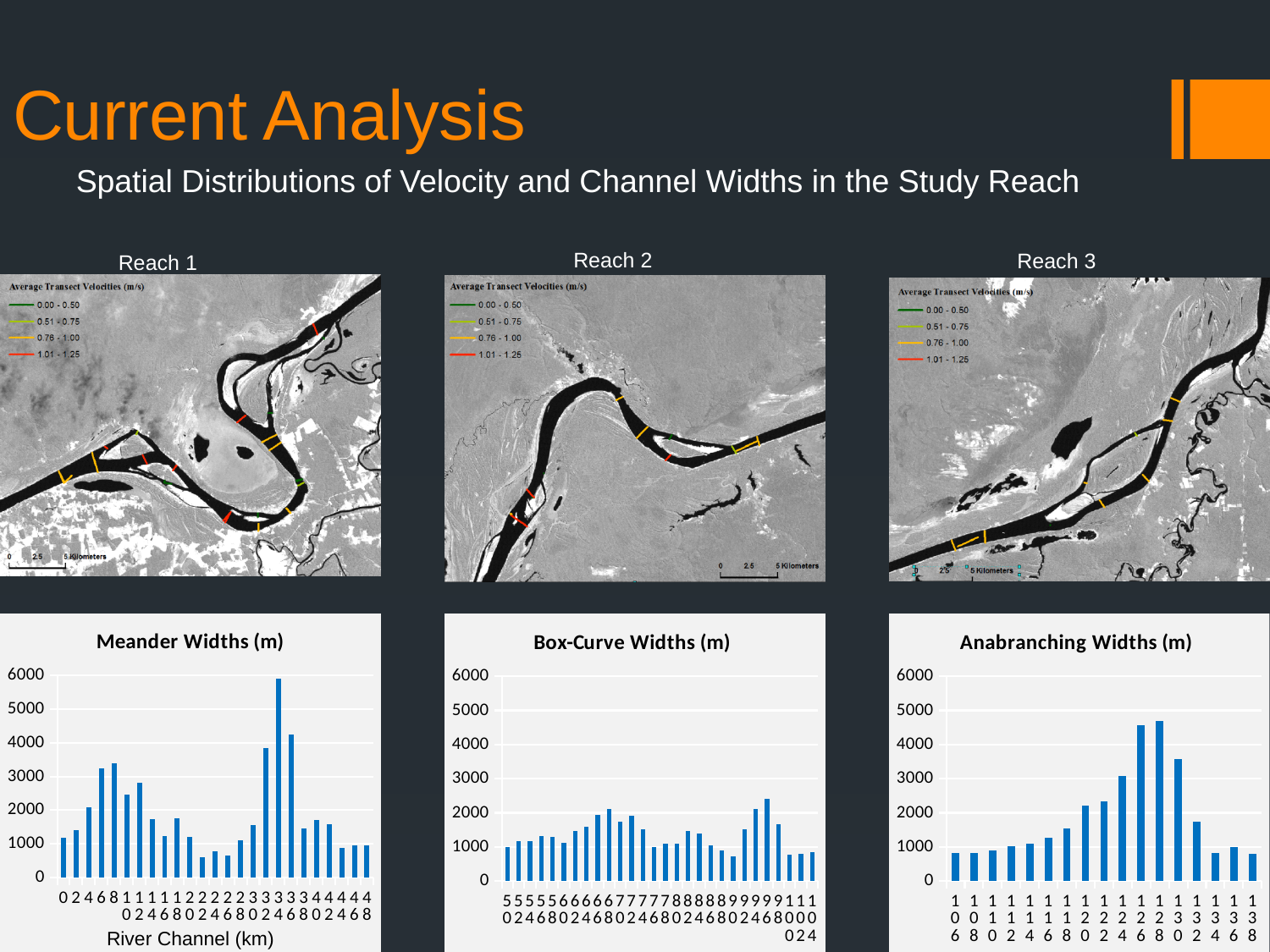
How many bars are plotted in the Anabranching Widths (m) chart? 17 Which of the three width charts contains the tallest bar overall? Meander Widths (m) What is the title of the chart below the Reach 3 map? Anabranching Widths (m) In the Meander Widths (m) chart, is the shortest bar greater or less than 1000? less How many bars are plotted in the Meander Widths (m) chart? 25 What is the x-axis title of the Meander Widths (m) chart? River Channel (km) In the Anabranching Widths (m) chart, is the tallest bar greater or less than 4000? greater In the Anabranching Widths (m) chart, do the bars generally rise or fall across the first ten categories? rise What kind of chart is the Meander Widths (m) chart? bar chart In the Box-Curve Widths (m) chart, is the tallest bar greater or less than 3000? less How many bars are plotted in the Box-Curve Widths (m) chart? 28